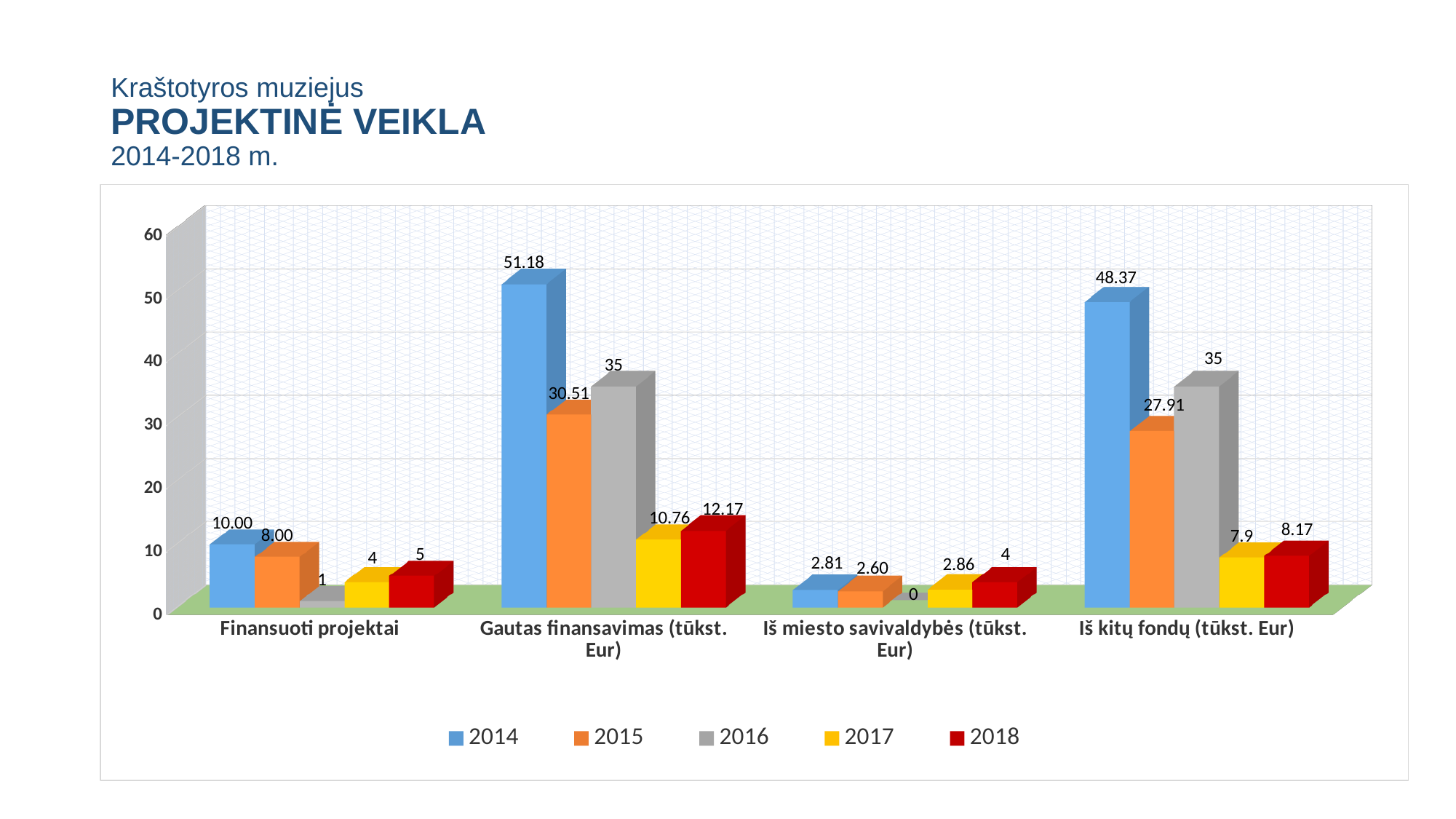
How many series does the legend list? 5 What is the value for 2016 in the "Iš miesto savivaldybės (tūkst. Eur)" category? 0 Which year has the highest value in the "Iš kitų fondų (tūkst. Eur)" category? 2014 What is the value for 2016 in the "Finansuoti projektai" category? 1 What is the value for 2014 in the "Gautas finansavimas (tūkst. Eur)" category? 51.18 How many categories are shown on the x axis of the chart? 4 Which colour represents the 2018 series in the chart? Dark red What is the value for 2018 in the "Iš kitų fondų (tūkst. Eur)" category? 8.17 In the "Iš miesto savivaldybės (tūkst. Eur)" category, which is larger: the value for 2017 or the value for 2015? 2017 What kind of chart is shown on the slide? Bar chart Which year has the lowest value in the "Finansuoti projektai" category? 2016 What is the difference between the 2014 and 2015 values in the "Gautas finansavimas (tūkst. Eur)" category? 20.67